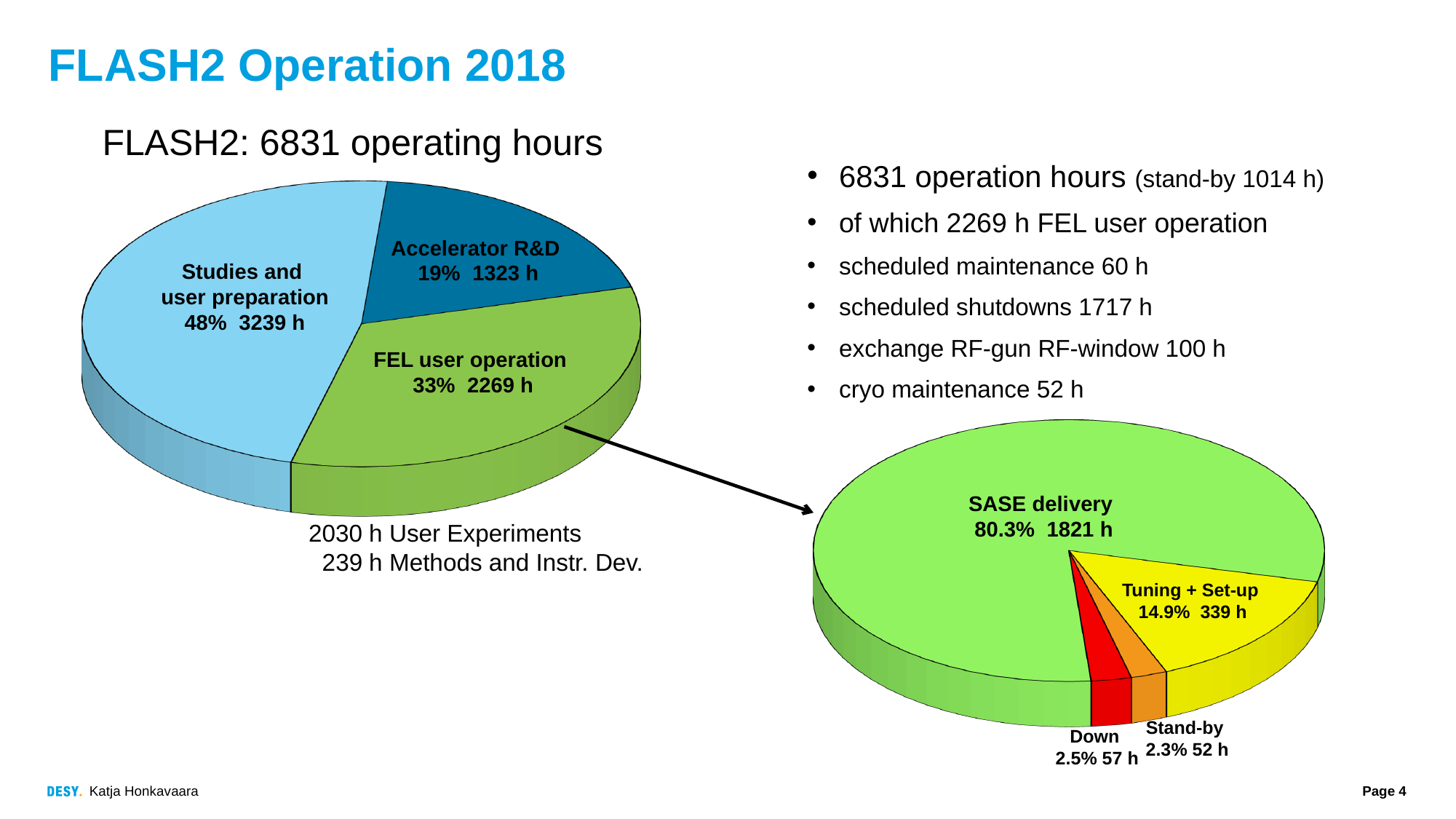
What type of chart is used on this slide? Pie chart In the left pie chart (FLASH2: 6831 operating hours), how many hours are shown for Accelerator R&D? 1323 h In the right pie chart, which is larger: Down or Stand-by? Down In the right pie chart (FEL user operation breakdown), how many hours are shown for SASE delivery? 1821 h In the left pie chart, how many hours more does Studies and user preparation have than FEL user operation? 970 h In the right pie chart, what percentage share does Tuning + Set-up have? 14.9% In the left pie chart, which category has the smallest slice? Accelerator R&D In the right pie chart, which category has the smallest slice? Stand-by How many slices does the left pie chart have? 3 How many slices does the right pie chart have? 4 In the left pie chart, what percentage share does Studies and user preparation have? 48% In the left pie chart, which category has the largest slice? Studies and user preparation